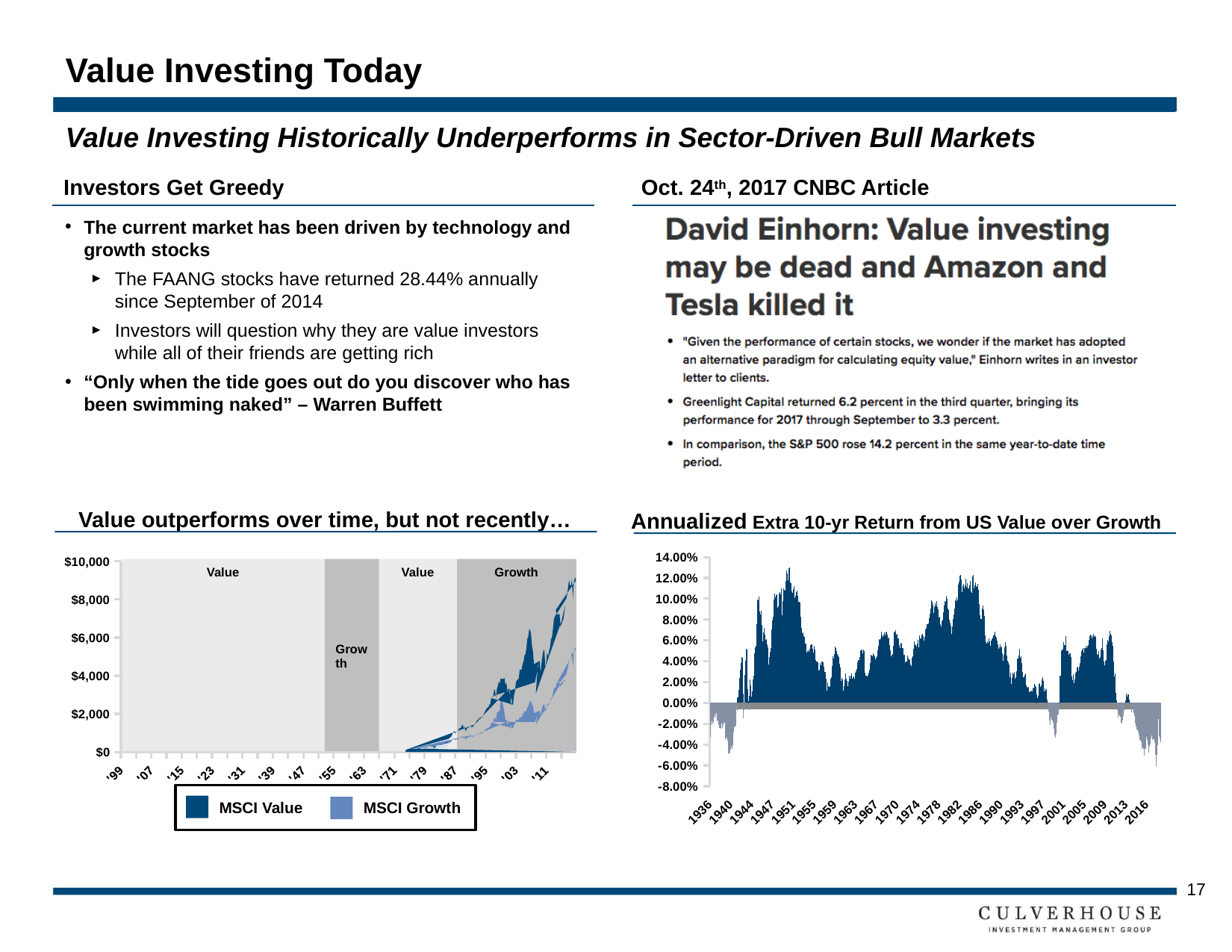
In the chart titled 'Value outperforms over time, but not recently…', how many series does the legend list? 2 In the 'Annualized Extra 10-yr Return from US Value over Growth' chart, is the value at 2016 greater or less than 0.00%? less In the chart titled 'Value outperforms over time, but not recently…', is the final value of MSCI Growth greater or less than $6,000? less In the chart titled 'Value outperforms over time, but not recently…', do the series generally rise or fall from left to right? rise In the chart titled 'Value outperforms over time, but not recently…', what is the highest value shown on the y axis? $10,000 In the 'Annualized Extra 10-yr Return from US Value over Growth' chart, what are the lowest and highest values shown on the y axis? -8.00% and 14.00% In the 'Annualized Extra 10-yr Return from US Value over Growth' chart, is the peak value around 1951 greater or less than 10.00%? greater In the chart titled 'Value outperforms over time, but not recently…', what are the two series named in the legend? MSCI Value and MSCI Growth In the chart titled 'Value outperforms over time, but not recently…', which series ends higher at the right edge of the chart, MSCI Value or MSCI Growth? MSCI Value What kind of chart is the 'Annualized Extra 10-yr Return from US Value over Growth' chart? area chart In the 'Annualized Extra 10-yr Return from US Value over Growth' chart, does the value rise or fall between 2009 and 2016? fall